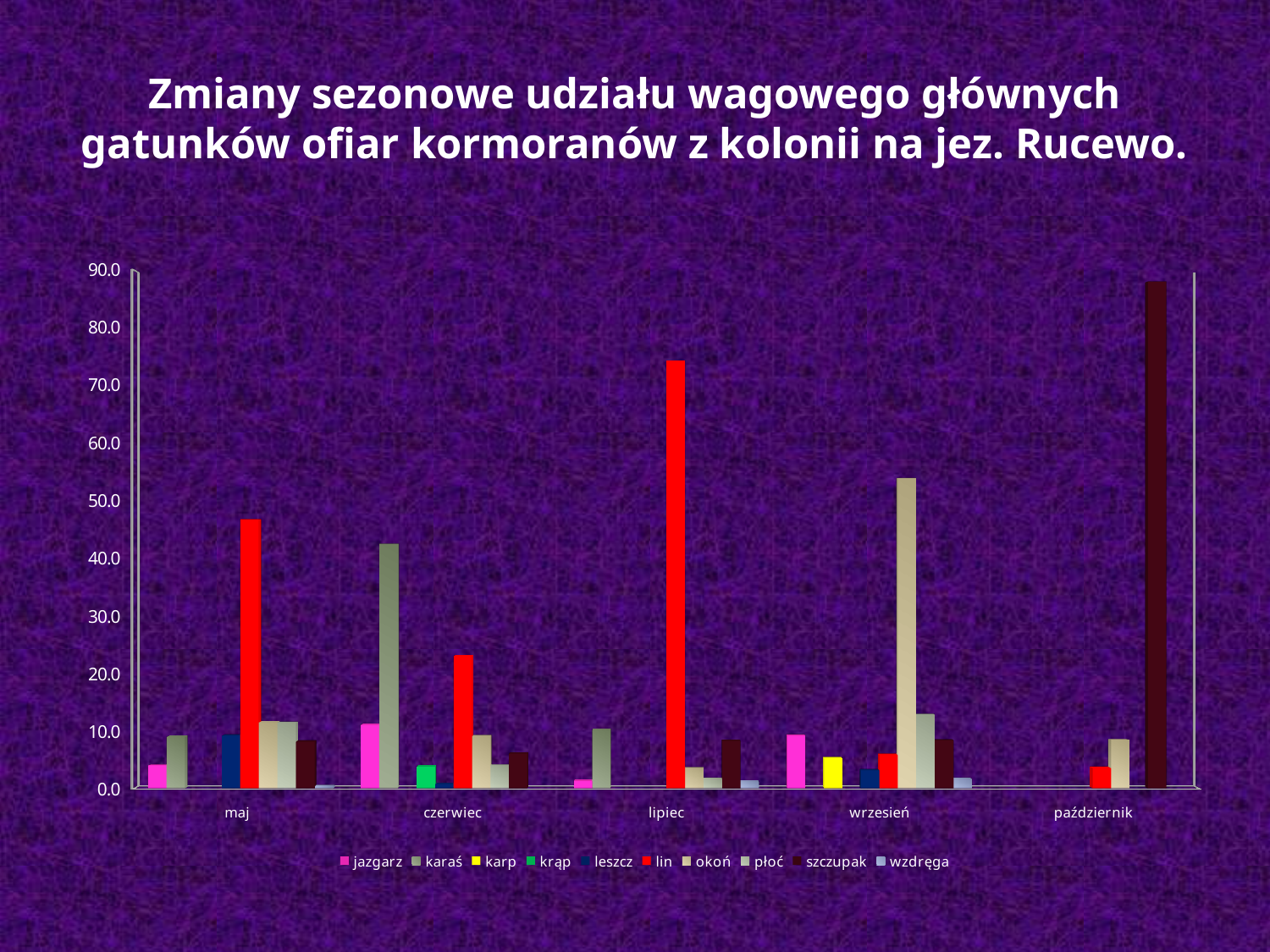
Which series has the highest value in wrzesień? okoń Is the value for okoń in wrzesień greater or less than 50? greater Is the value for karaś in czerwiec greater or less than 30? greater In czerwiec, which is larger: karaś or lin? karaś Which series has the highest value in maj? lin Is the value for szczupak in październik greater or less than 80? greater What kind of chart is shown on the slide? bar chart How many months (categories) are shown on the x axis? 5 How many series does the legend list? 10 Which is larger: the value for lin in maj or the value for lin in lipiec? lin in lipiec